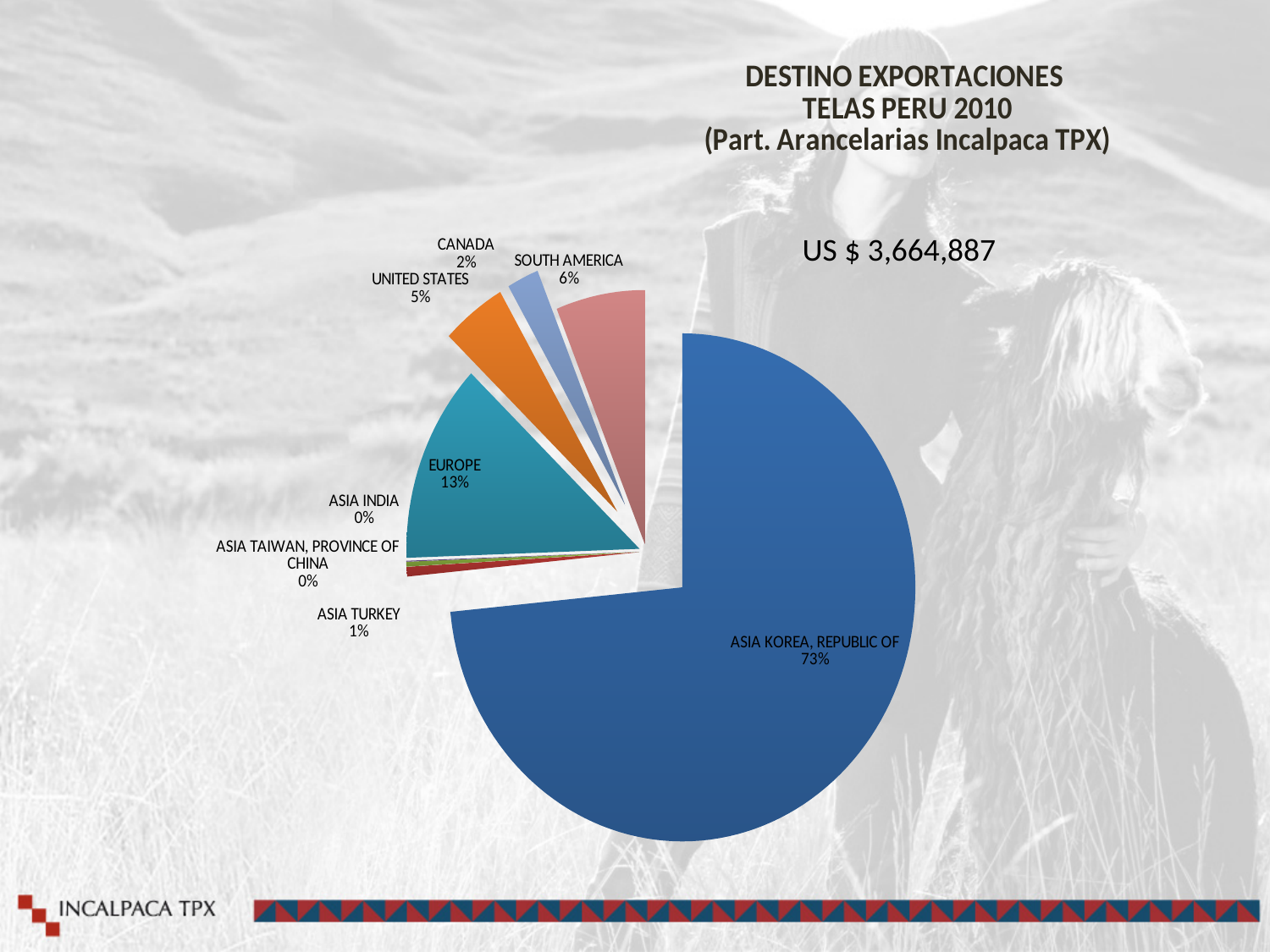
Which has a larger share, EUROPE or SOUTH AMERICA? EUROPE What total export value is shown next to the pie chart? US $ 3,664,887 What is the difference in percentage points between ASIA KOREA, REPUBLIC OF and EUROPE? 60 Which destination has the largest share of exports? ASIA KOREA, REPUBLIC OF What share of exports goes to EUROPE? 13% What type of chart is shown on the slide? pie chart How many destination slices are labeled in the pie chart? 8 What share of exports goes to ASIA KOREA, REPUBLIC OF? 73% What percentage is shown for SOUTH AMERICA? 6% What percentage is shown for CANADA? 2% What percentage is shown for ASIA TURKEY? 1% What percentage is shown for UNITED STATES? 5%